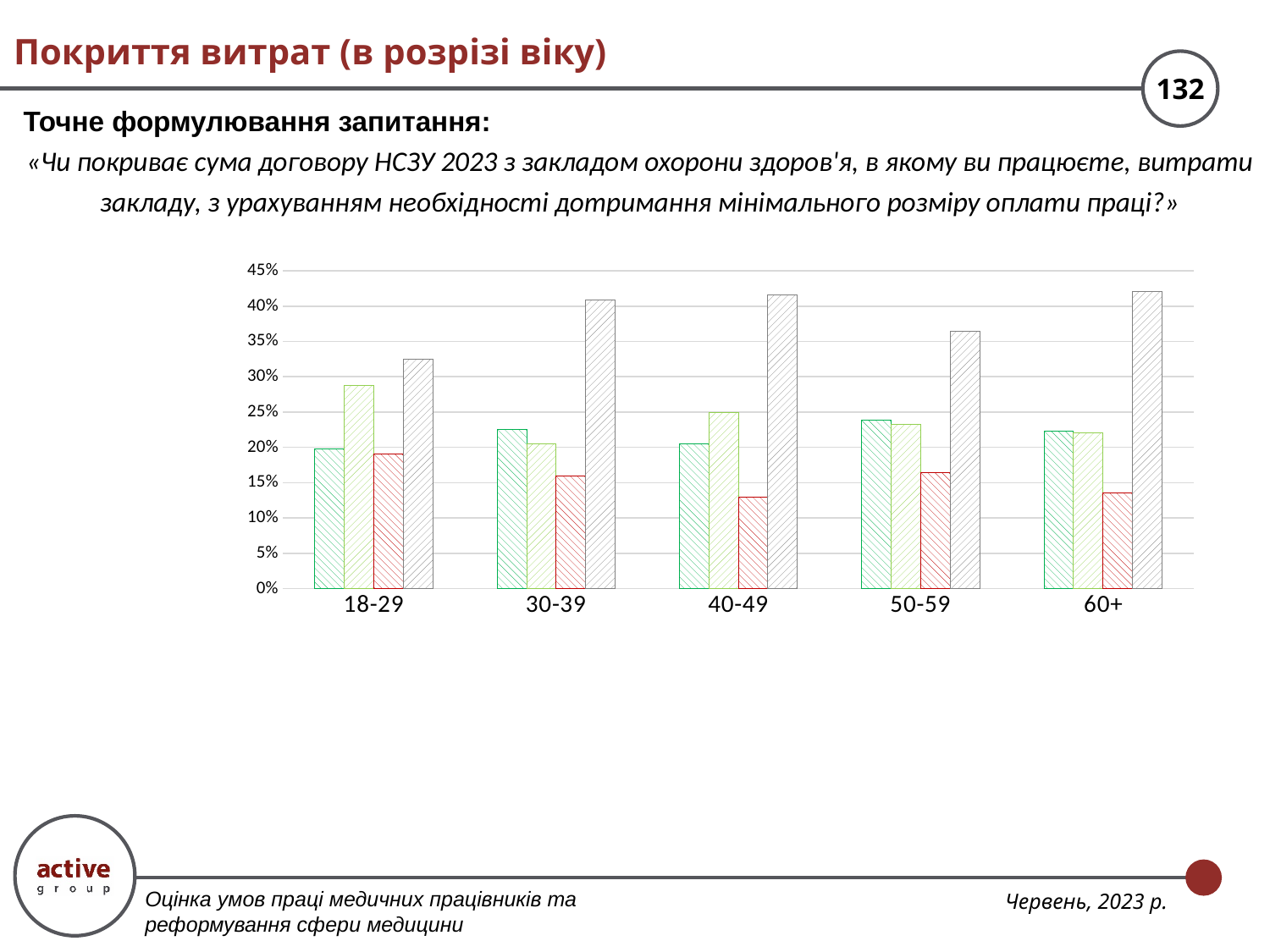
How many age groups are shown on the x axis of the chart? 5 How many bars are plotted for each age group in the chart? 4 What kind of chart is shown on the slide? bar chart Which age group has the lowest value for the rightmost (grey hatched) bar? 18-29 Is the value of the rightmost (grey hatched) bar in the 60+ group greater or less than 40%? greater Is the value of the red hatched bar in the 40-49 group greater or less than 15%? less In the 18-29 group, which is taller: the red hatched bar or the rightmost grey hatched bar? the rightmost grey hatched bar Is the value of the light green hatched bar in the 18-29 group greater or less than 25%? greater What is the highest value shown on the chart's y axis? 45%